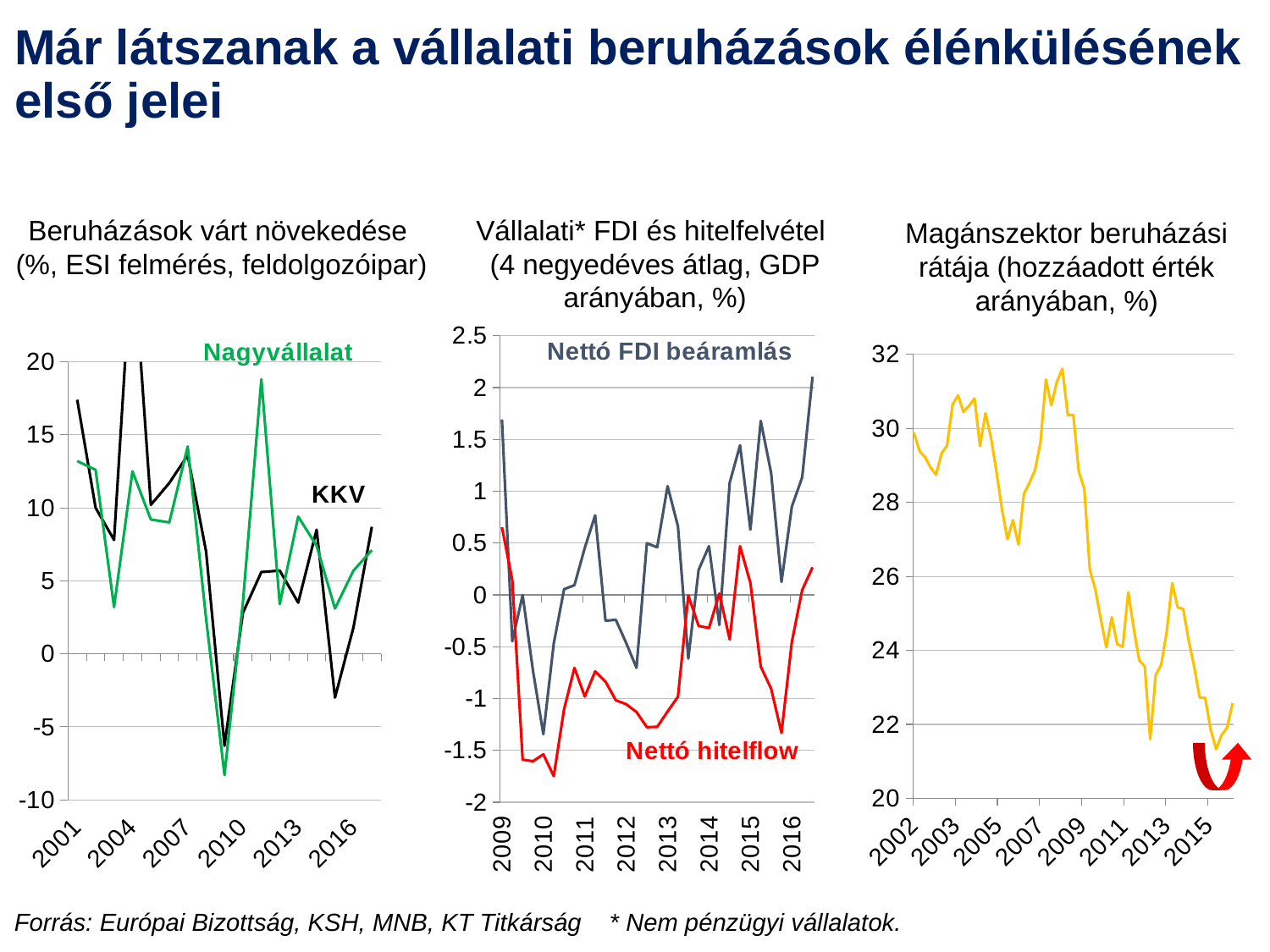
In the middle chart 'Vállalati* FDI és hitelfelvétel', which series is drawn in red? Nettó hitelflow In the middle chart 'Vállalati* FDI és hitelfelvétel', is the final value of the Nettó FDI beáramlás series in 2016 greater or less than 1.5? greater How many series does the middle chart 'Vállalati* FDI és hitelfelvétel' show? 2 In the middle chart 'Vállalati* FDI és hitelfelvétel', which series has the lower value in 2010, Nettó FDI beáramlás or Nettó hitelflow? Nettó hitelflow In the left chart 'Beruházások várt növekedése', which series is drawn in green? Nagyvállalat In the right chart 'Magánszektor beruházási rátája', do the values generally rise or fall from 2002 to 2015? fall How many series does the left chart 'Beruházások várt növekedése' show? 2 In the left chart 'Beruházások várt növekedése', is the peak value of the Nagyvállalat series around 2011 greater or less than 15? greater What kind of chart is the left chart titled 'Beruházások várt növekedése'? line chart In the left chart 'Beruházások várt növekedése', is the lowest value of the KKV series around 2009 greater or less than -5? less